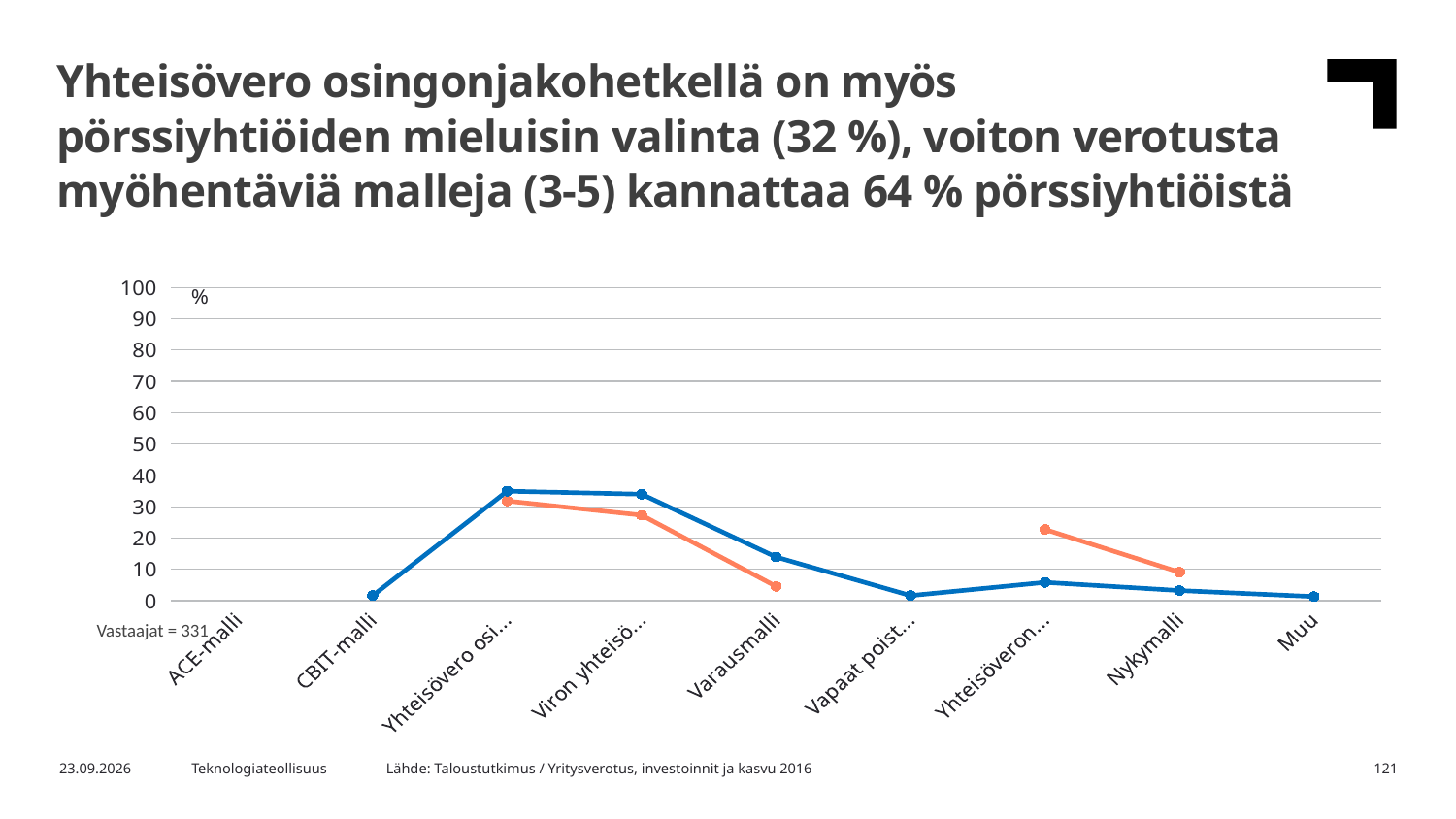
On the blue line, which is larger: the value for Varausmalli or the value for Nykymalli? Varausmalli On the orange line, which is larger: the value for Viron yhteisö... or the value for Varausmalli? Viron yhteisö... Does the blue line rise or fall from Viron yhteisö... to Vapaat poist...? fall Is the value of the orange line for Varausmalli greater or less than 10? less What kind of chart is shown on the slide? line chart How many categories are shown on the x axis of the chart? 9 How many lines are plotted on the chart? 2 What is the highest value shown on the y axis of the chart? 100 Is the value of the blue line for Varausmalli greater or less than 10? greater Is the value of the orange line for Yhteisöveron... greater or less than 20? greater